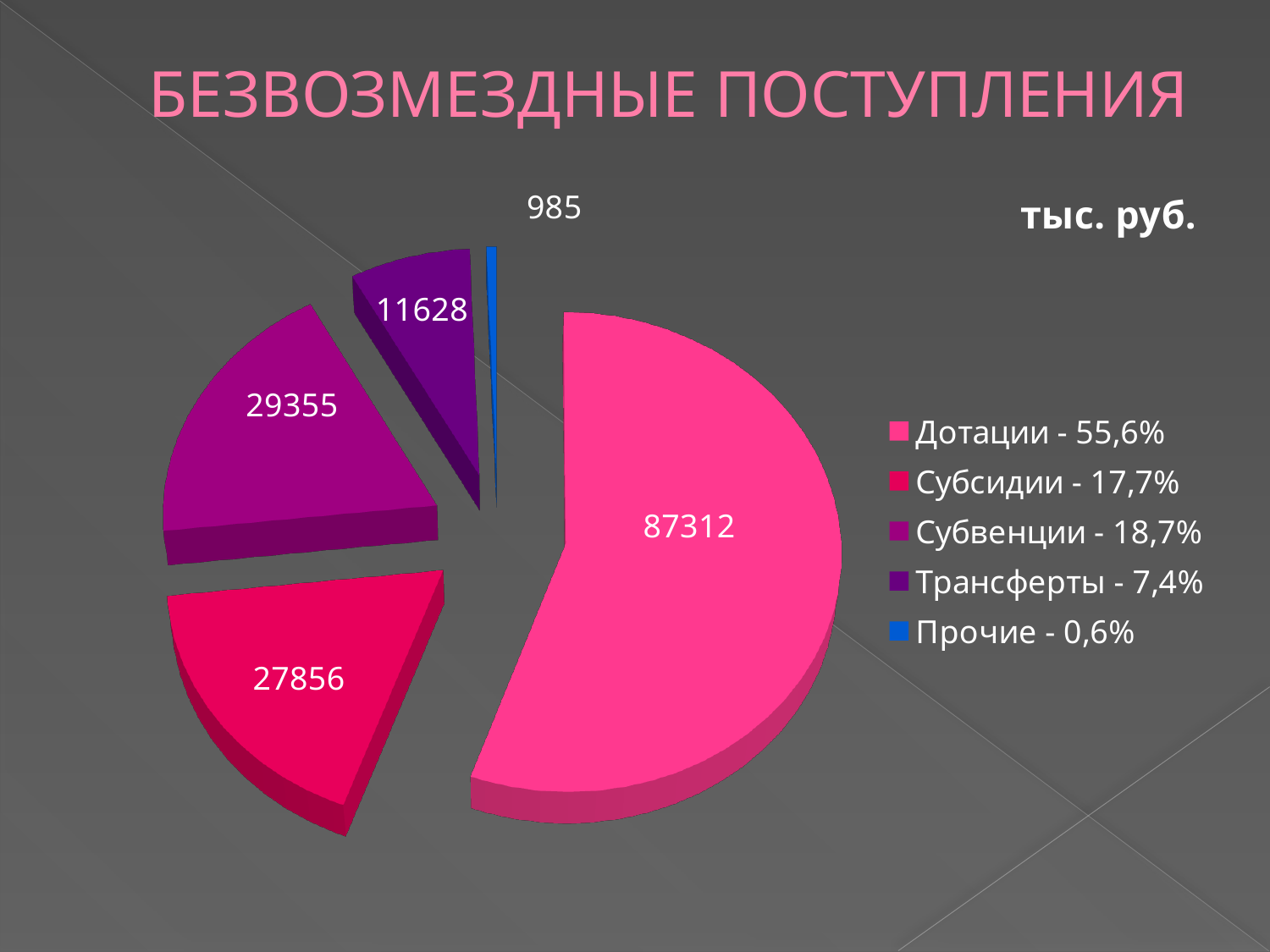
What share of the pie does Трансферты represent? 7,4% What is the value for Дотации? 87312 Which category has the largest slice? Дотации Which is larger, Субсидии or Субвенции? Субвенции How many categories does the pie chart have? 5 What is the value for Прочие? 985 What is the difference between the values for Субвенции and Субсидии? 1499 What type of chart is shown on the slide? Pie chart What is the value for Трансферты? 11628 What share of the pie does Субвенции represent? 18,7% Which category has the smallest slice? Прочие What is the value for Субвенции? 29355